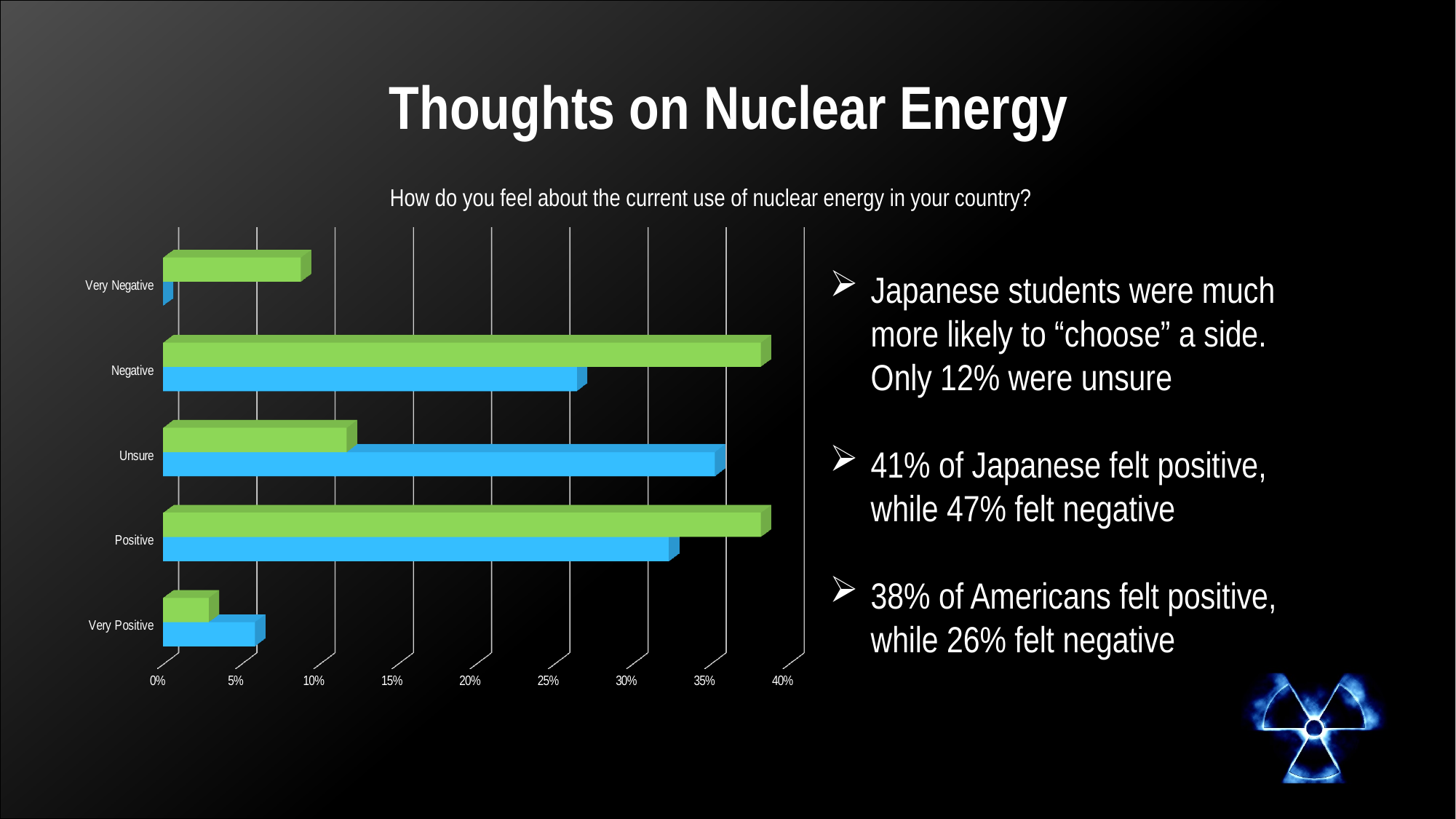
How many series of bars (colours) are plotted for each category? 2 For the Negative category, which bar is longer, the green one or the blue one? green For the Unsure category, which bar is longer, the green one or the blue one? blue Is the blue bar for Very Positive greater or less than 10%? less Which category has the longest blue bar? Unsure Is the green bar for Negative greater or less than 35%? greater Is the green bar for Unsure greater or less than 15%? less What question is shown as the chart's title above the bars? How do you feel about the current use of nuclear energy in your country? Which category has the shortest blue bar? Very Negative How many categories are shown on the chart's vertical axis? 5 What kind of chart is shown on the slide? bar chart